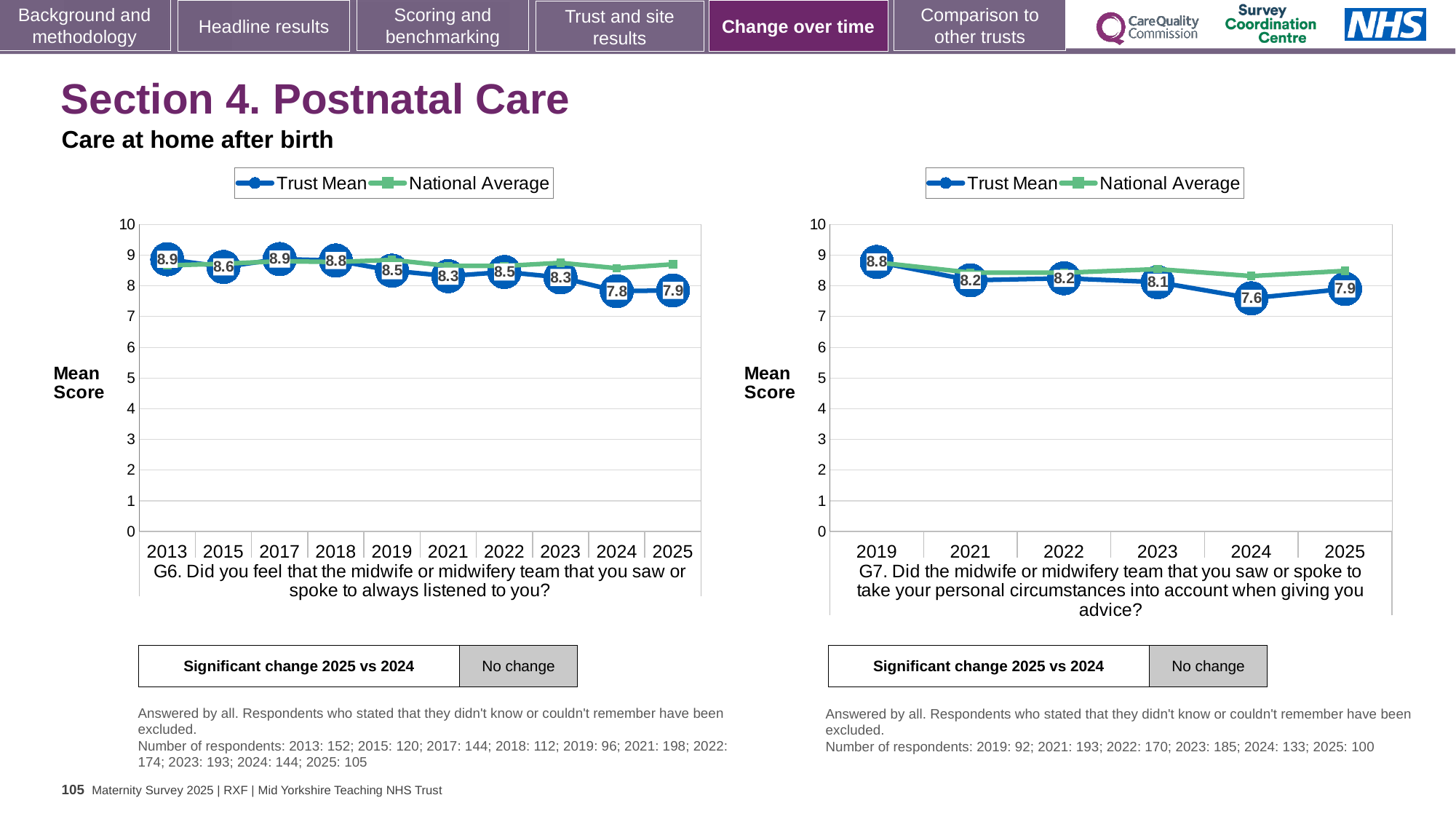
In the left chart (G6), which year has the lowest Trust Mean? 2024 In the left chart (G6), what is the Trust Mean for 2025? 7.9 In the right chart (G7), is the Trust Mean for 2025 greater or less than the Trust Mean for 2024? greater In the left chart (G6), how many years are shown on the x axis? 10 What type of chart is the right chart (G7)? line chart In the right chart (G7), what is the Trust Mean for 2024? 7.6 In the right chart (G7), how many series does the legend list? 2 In the left chart (G6), what is the Trust Mean for 2013? 8.9 In the left chart (G6), what is the difference between the Trust Mean in 2013 and in 2025? 1.0 In the left chart (G6), does the Trust Mean generally rise or fall from 2013 to 2025? fall In the right chart (G7), what is the difference between the Trust Mean in 2019 and in 2024? 1.2 In the right chart (G7), which year has the highest Trust Mean? 2019